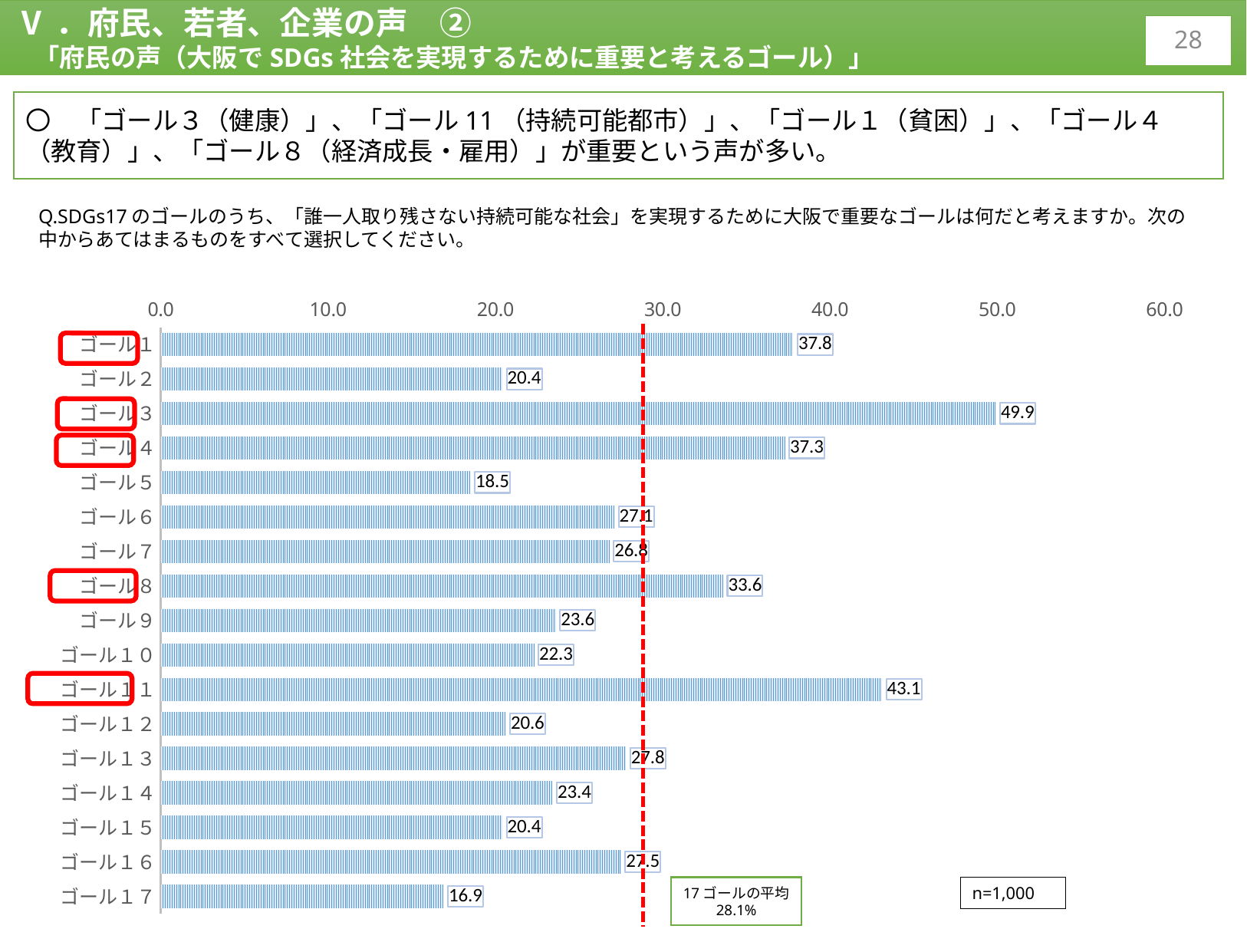
What is the difference between the values for ゴール3 and ゴール11? 6.8 What kind of chart is shown on the slide? bar chart What is the value for ゴール17? 16.9 What is the value for ゴール3? 49.9 What is the value for ゴール11? 43.1 Which goal has the lowest value? ゴール17 Which goal has the highest value? ゴール3 What is the average of the 17 goals shown in the box on the chart? 28.1% Is the value for ゴール5 greater or less than 20.0? less How many goals (categories) are plotted in the chart? 17 Which is larger, the value for ゴール1 or the value for ゴール8? ゴール1 What sample size (n) is shown on the chart? n=1,000